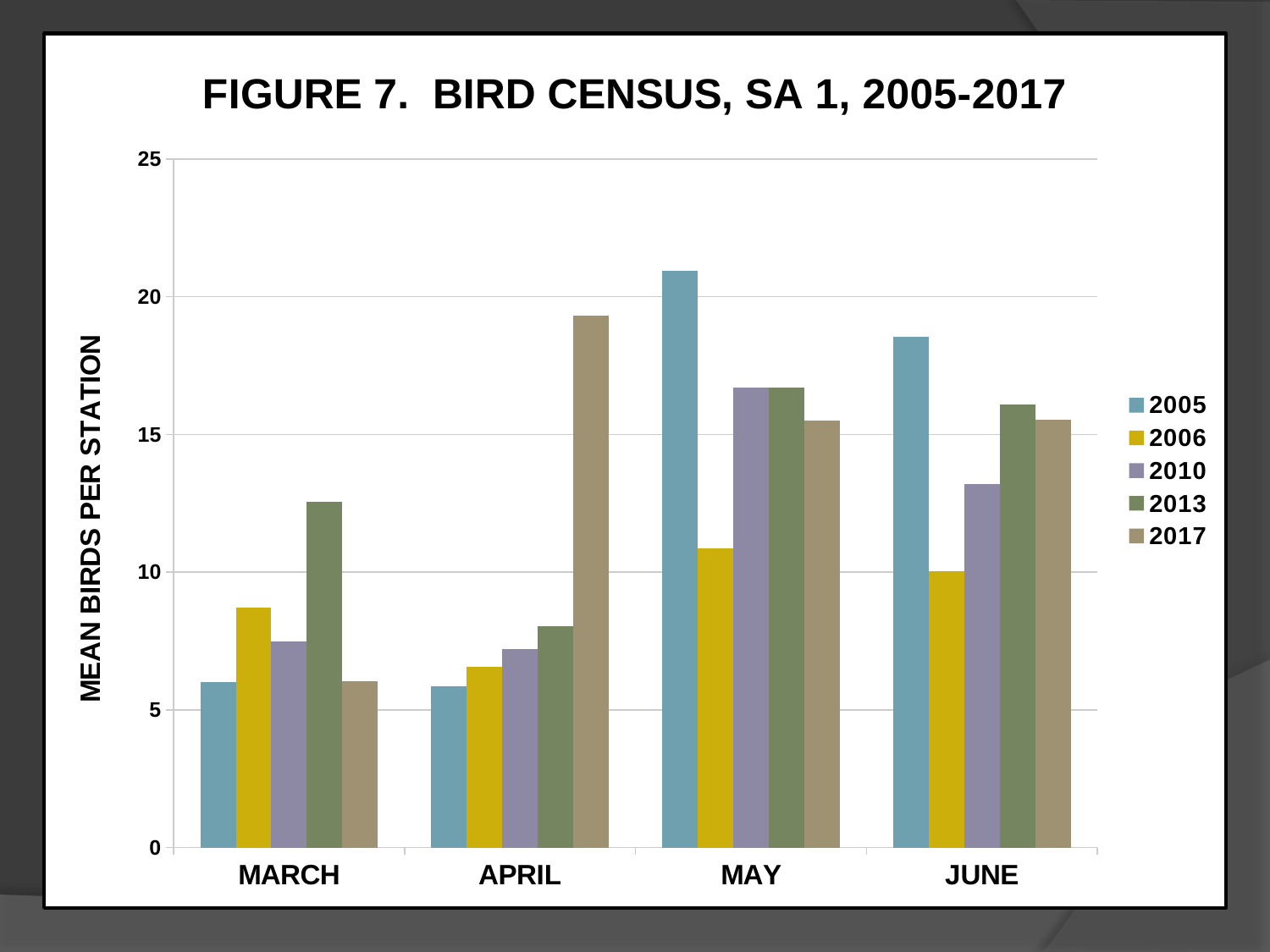
In March, which is larger: the value for 2013 or the value for 2006? 2013 What is the title of the y axis? MEAN BIRDS PER STATION How many series does the legend list? 5 In April, which year has the highest mean birds per station? 2017 In May, which year has the highest mean birds per station? 2005 How many months are shown on the x axis? 4 What kind of chart is shown on the slide? bar chart In June, which year has the lowest mean birds per station? 2006 Is the value for 2006 in June greater or less than 15? less Is the value for 2017 in April greater or less than 15? greater Does the value for 2017 rise or fall from March to April? rise Is the value for 2005 in May greater or less than 20? greater